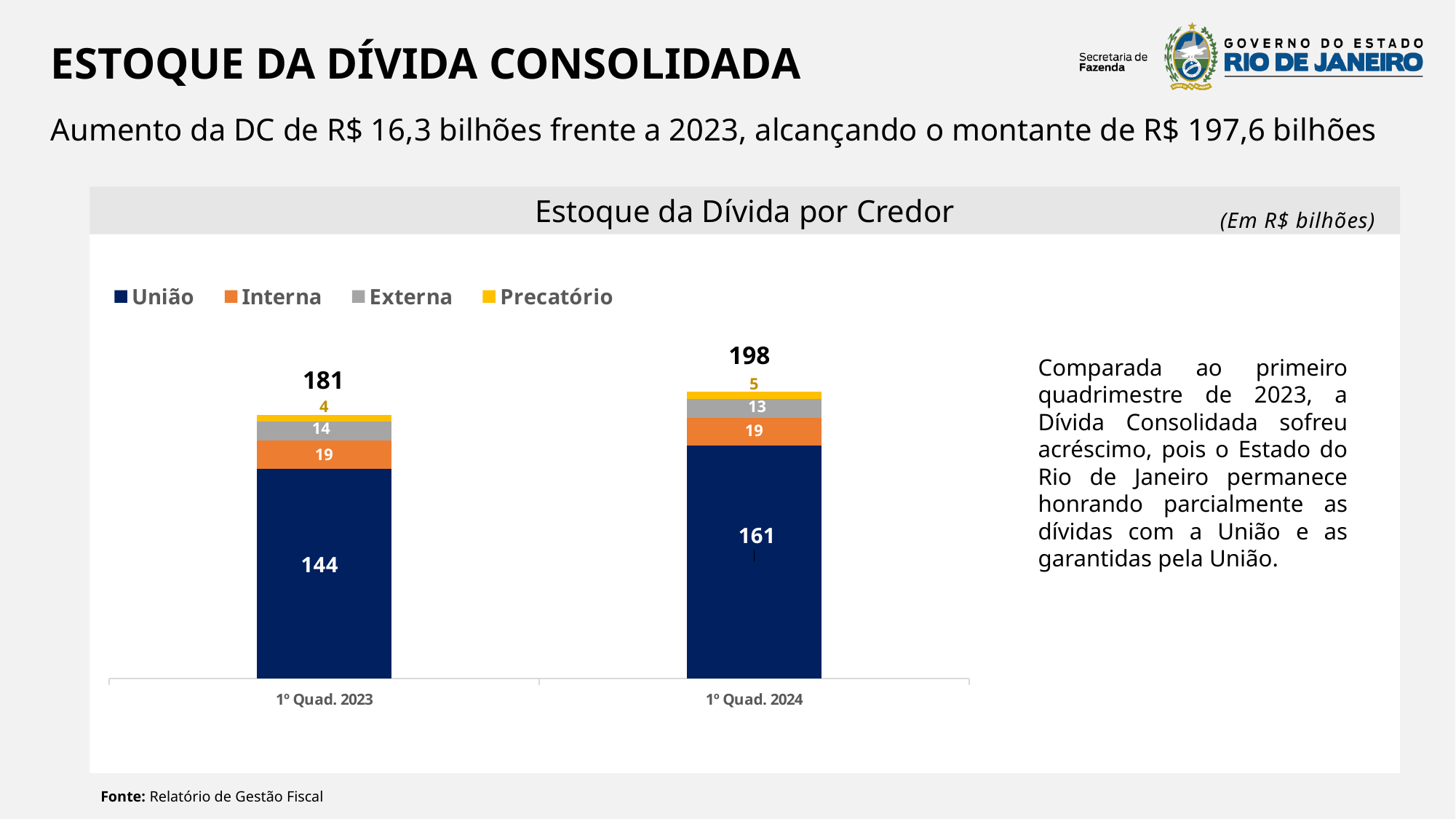
Which period has the larger total stacked bar, 1º Quad. 2023 or 1º Quad. 2024? 1º Quad. 2024 What is the total of the stacked bar for 1º Quad. 2023? 181 What is the total of the stacked bar for 1º Quad. 2024? 198 What is the value of União for 1º Quad. 2024? 161 What kind of chart is shown? Stacked bar chart How many series does the legend list? 4 How many categories are shown on the x axis? 2 What is the value of Externa for 1º Quad. 2023? 14 Which series has the smallest value in 1º Quad. 2023? Precatório What is the difference between the União values for 1º Quad. 2024 and 1º Quad. 2023? 17 What is the value of Precatório for 1º Quad. 2024? 5 Which series has the largest value in 1º Quad. 2024? União